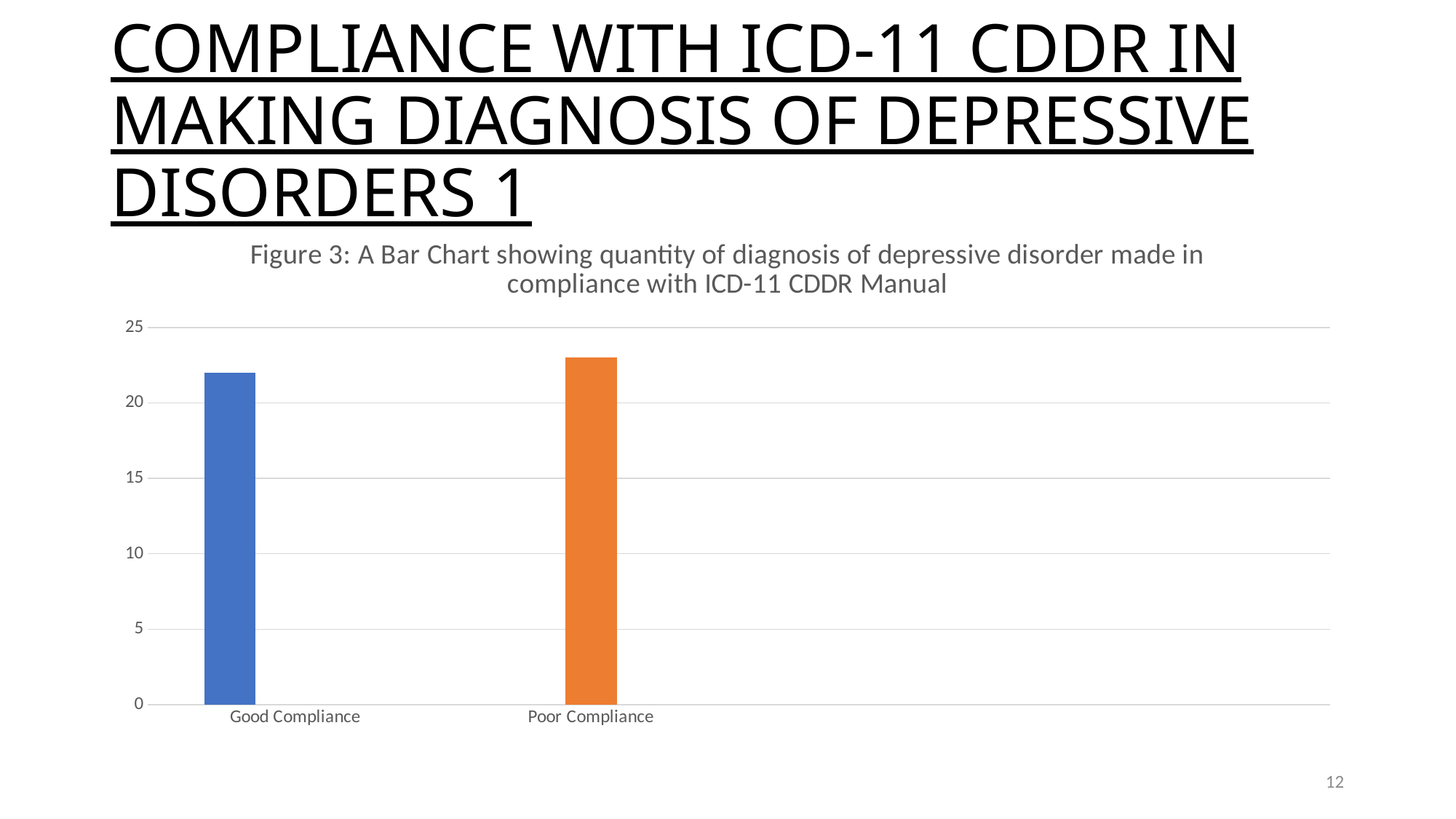
How many categories are shown on the x axis of the chart? 2 Which category has the highest value in the chart? Poor Compliance Is the value for Poor Compliance greater or less than 25? less Is the value for Poor Compliance greater or less than 20? greater What colour is the bar for Poor Compliance? Orange Is the value for Good Compliance greater or less than 20? greater What kind of chart is shown on the slide? Bar chart Which category has the taller bar, Good Compliance or Poor Compliance? Poor Compliance What is the highest value shown on the y axis of the chart? 25 Which category has the lowest value in the chart? Good Compliance